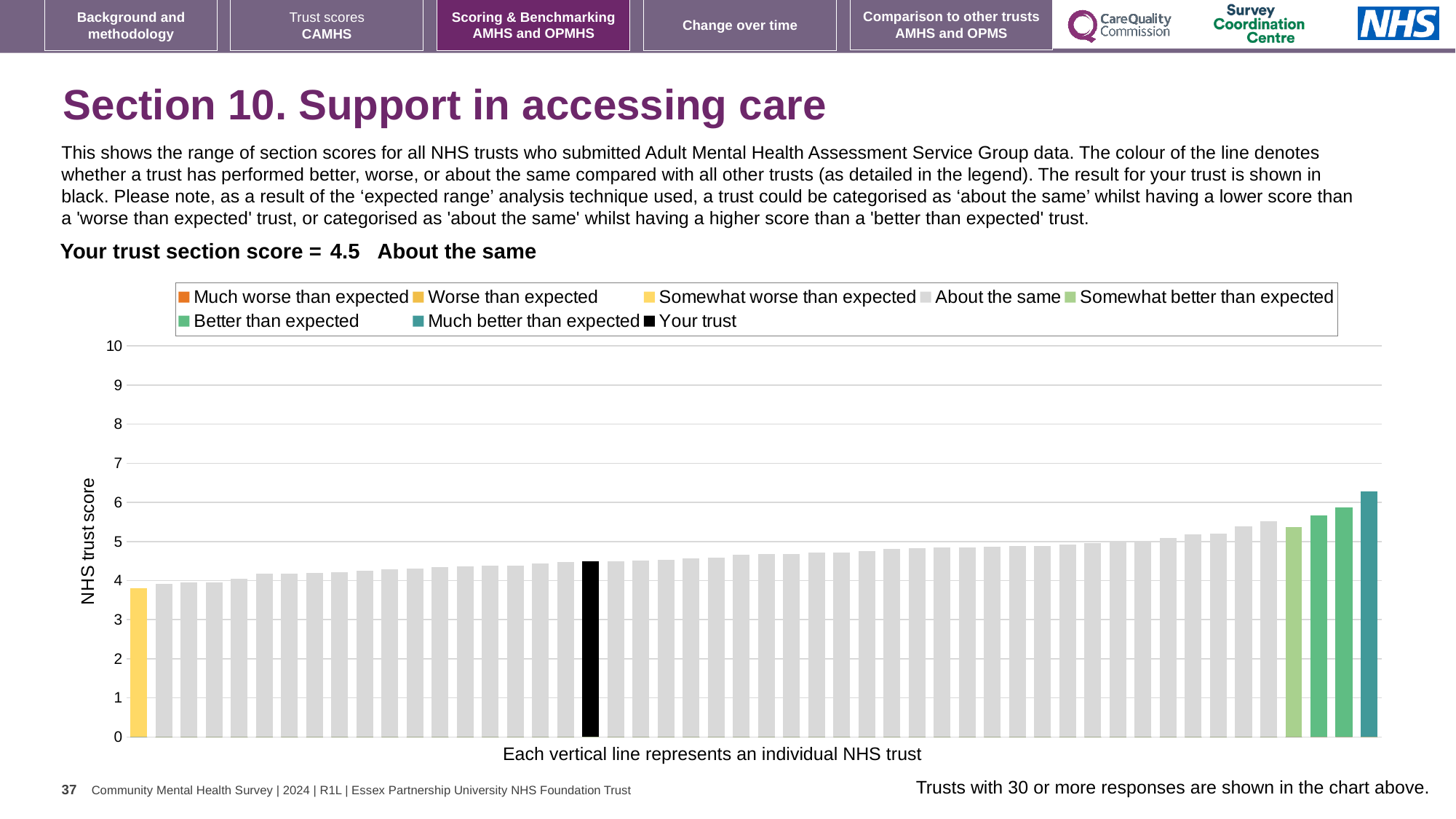
How many bars are coloured as 'Better than expected'? 2 What is the section score for your trust? 4.5 Which legend category does the tallest bar belong to? Much better than expected What colour is the bar representing your trust? black Is the value of the shortest bar greater or less than 5? less How many entries does the chart legend list? 8 What kind of chart is shown on the slide? bar chart Is the value of the tallest bar greater or less than 7? less What is the label on the y axis of the chart? NHS trust score Which category is your trust placed in, according to the text above the chart? About the same Do the bar values rise or fall from left to right along the x axis? rise Is the value for your trust greater or less than 4? greater